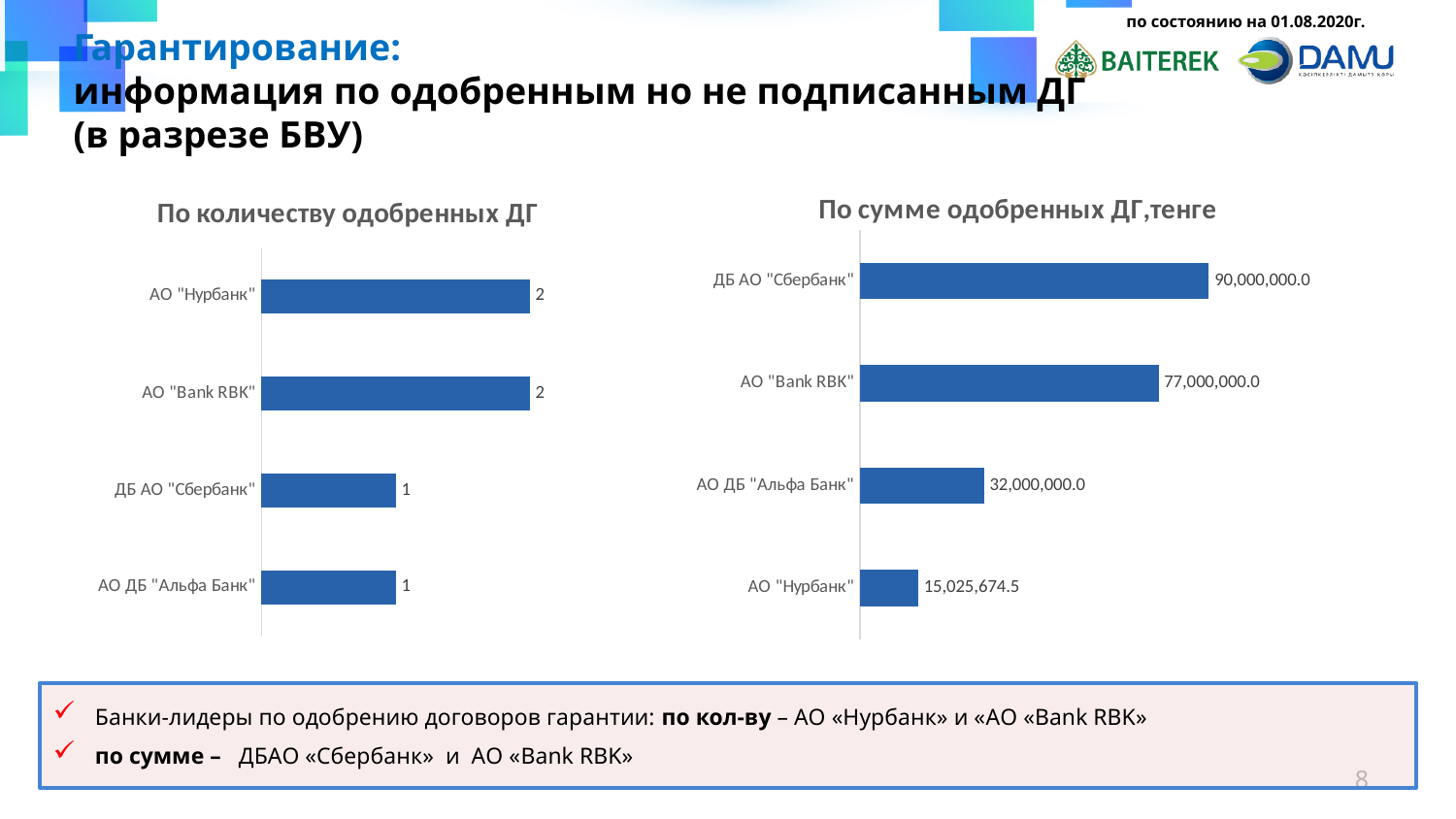
In the chart "По сумме одобренных ДГ,тенге", what is the value for АО "Нурбанк"? 15,025,674.5 In the chart "По сумме одобренных ДГ,тенге", what is the value for ДБ АО "Сбербанк"? 90,000,000.0 In the chart "По сумме одобренных ДГ,тенге", which bank has the lowest value? АО "Нурбанк" In the chart "По сумме одобренных ДГ,тенге", what is the difference between ДБ АО "Сбербанк" and АО "Bank RBK"? 13,000,000.0 In the chart "По сумме одобренных ДГ,тенге", which bank has the highest value? ДБ АО "Сбербанк" What type of chart is "По сумме одобренных ДГ,тенге"? Bar chart In the chart "По количеству одобренных ДГ", what is the value for АО "Bank RBK"? 2 What is the title of the chart on the right side of the slide? По сумме одобренных ДГ,тенге In the chart "По количеству одобренных ДГ", what is the difference between АО "Нурбанк" and ДБ АО "Сбербанк"? 1 In the chart "По сумме одобренных ДГ,тенге", which is larger: АО ДБ "Альфа Банк" or АО "Нурбанк"? АО ДБ "Альфа Банк" In the chart "По количеству одобренных ДГ", what is the value for АО ДБ "Альфа Банк"? 1 How many banks are shown in the chart "По количеству одобренных ДГ"? 4